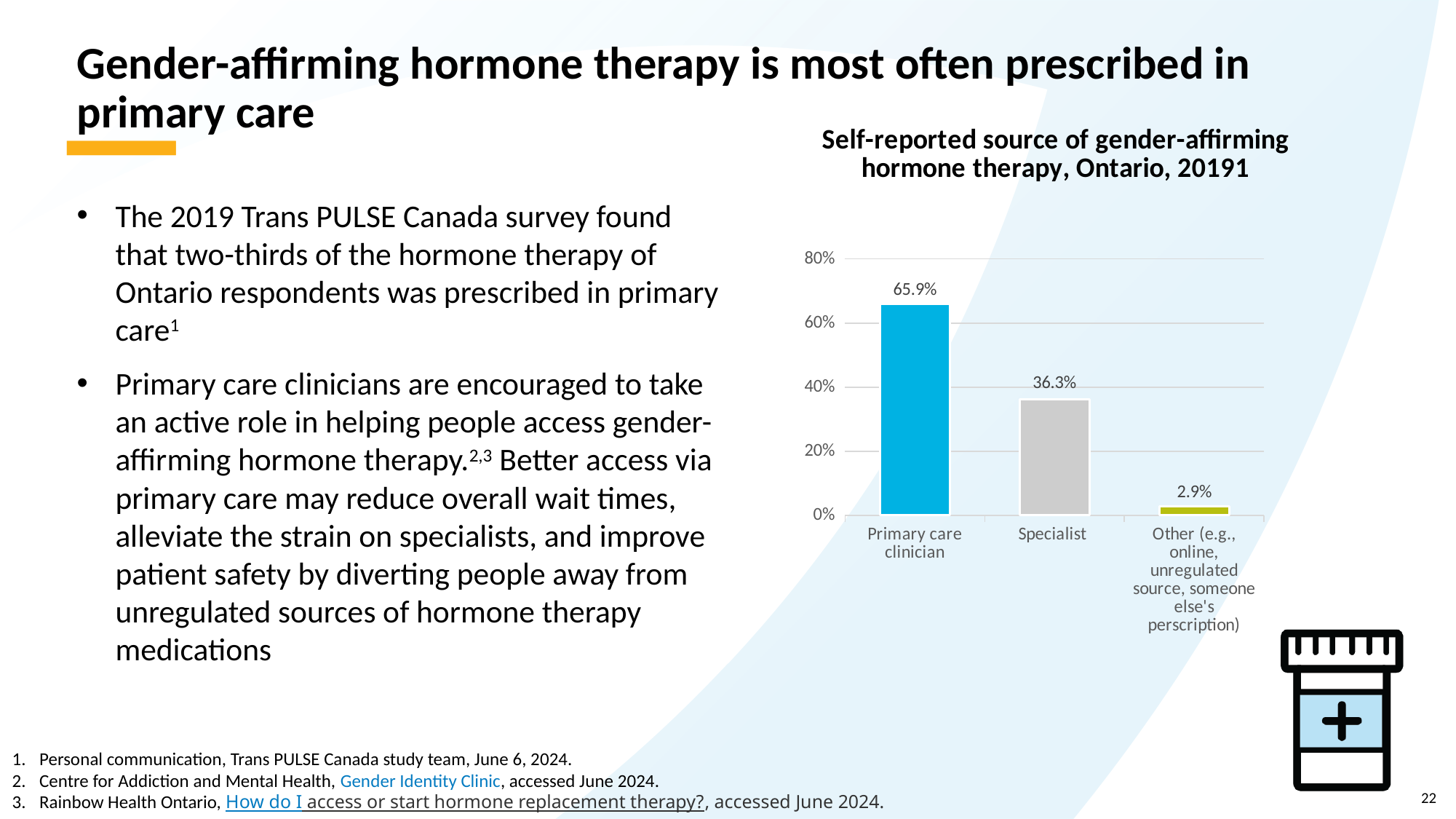
What is the value for Specialist? 36.3% What kind of chart is shown on the slide? Bar chart What is the value for Primary care clinician? 65.9% What is the value for the Other category (e.g., online, unregulated source, someone else's prescription)? 2.9% What is the title of the chart? Self-reported source of gender-affirming hormone therapy, Ontario, 2019 Which is larger, the value for Specialist or the value for Other? Specialist Which category has the lowest value? Other (e.g., online, unregulated source, someone else's perscription) Which category has the highest value? Primary care clinician What is the difference between the values for Primary care clinician and Specialist? 29.6% How many categories are shown on the chart? 3 Do the values rise or fall from left to right across the categories? Fall Is the value for Specialist greater or less than 40%? less